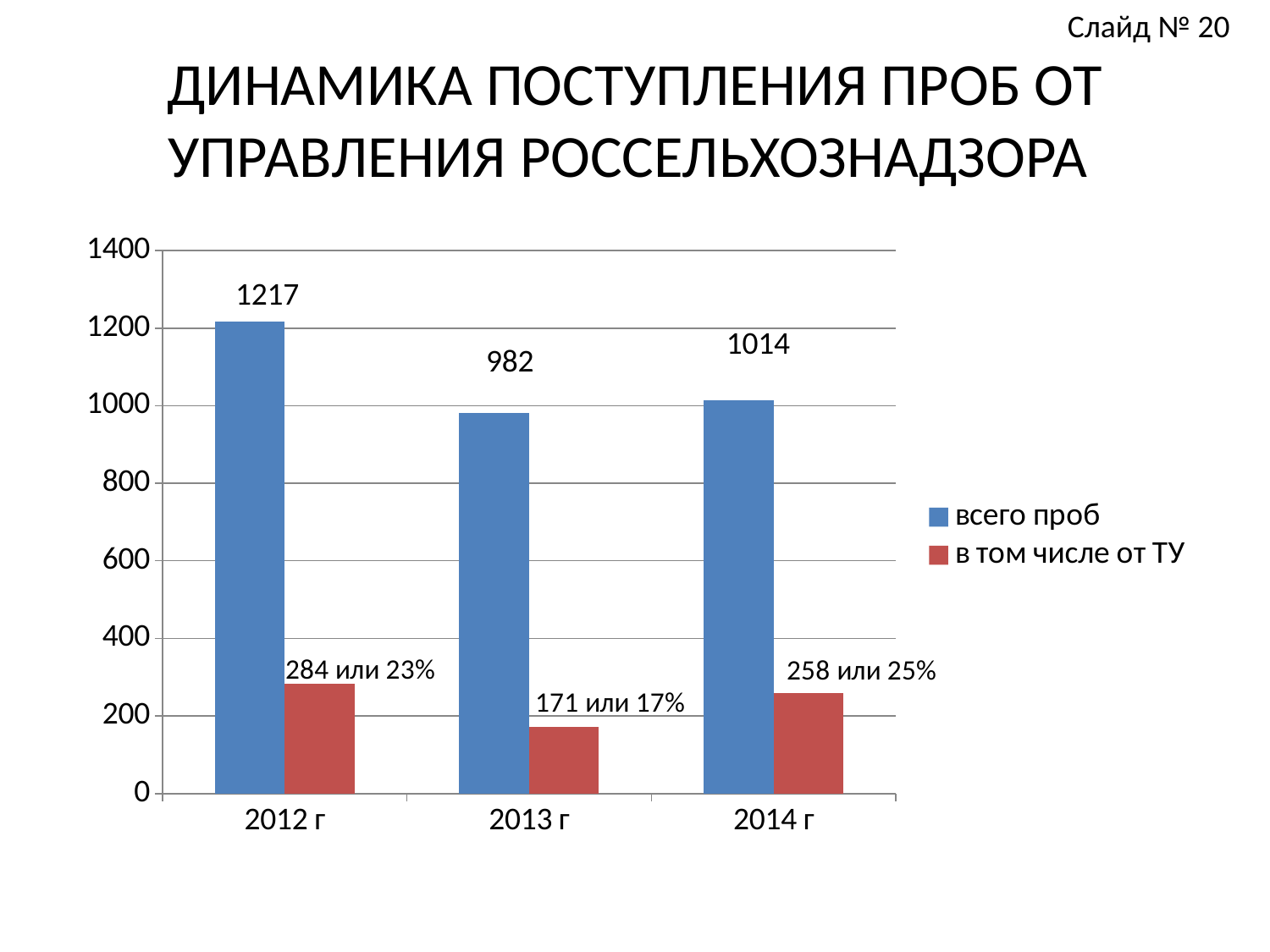
How many series does the legend list? 2 Which is larger: "всего проб" in 2014 г or in 2013 г? 2014 г What kind of chart is shown on the slide? bar chart What is the data label on the "в том числе от ТУ" bar for 2013 г? 171 или 17% Is the value of "в том числе от ТУ" for 2012 г greater or less than 200? greater What is the value of "всего проб" for 2013 г? 982 What is the value of "всего проб" for 2012 г? 1217 How many years are shown on the x axis? 3 What is the data label on the "в том числе от ТУ" bar for 2014 г? 258 или 25% Which year has the highest value for "всего проб"? 2012 г What is the difference between "всего проб" in 2012 г and 2013 г? 235 Which year has the lowest value for "в том числе от ТУ"? 2013 г